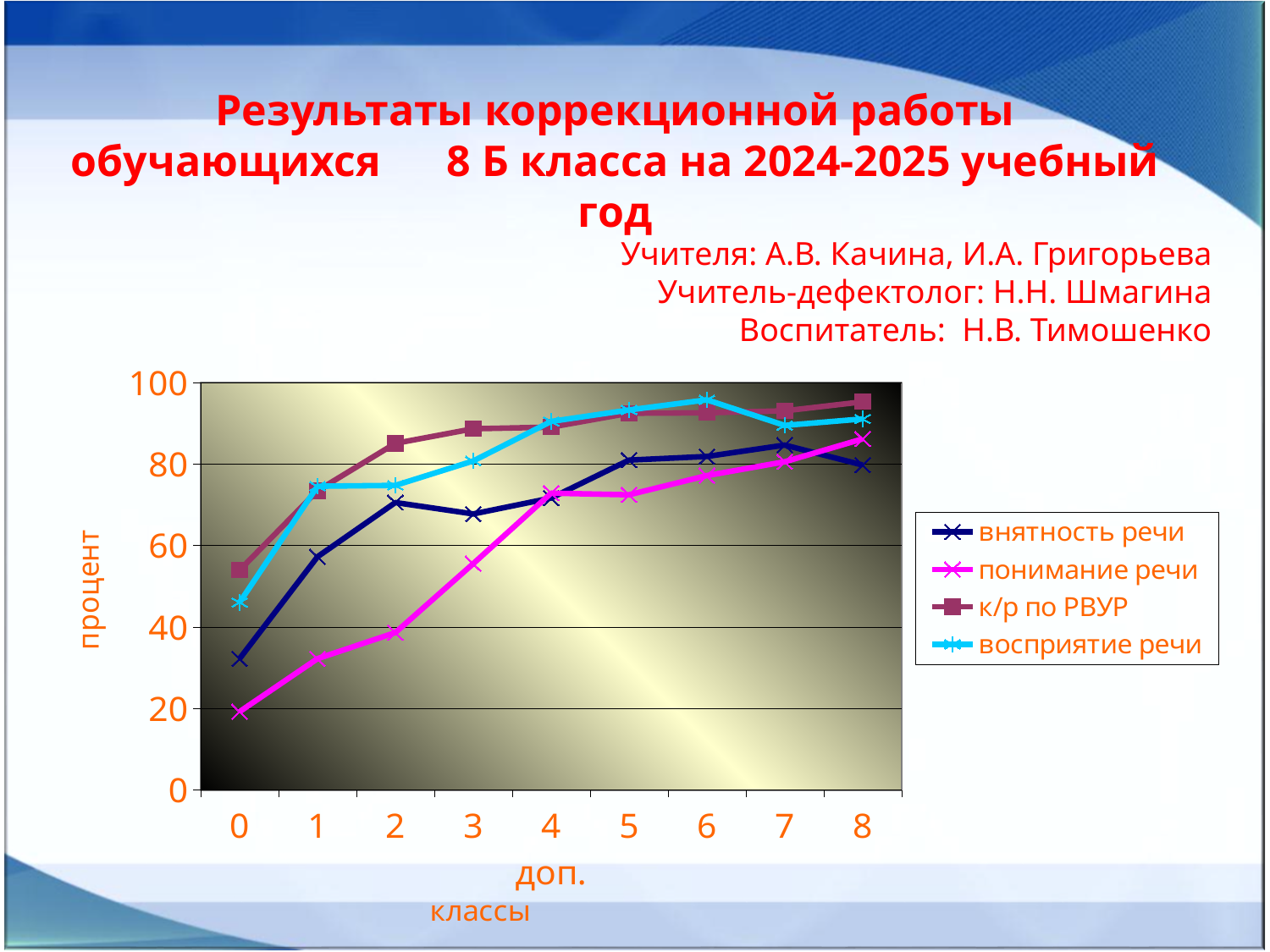
Do the values for понимание речи rise or fall from category 0 to category 8? rise At category 3, which is higher: к/р по РВУР or внятность речи? к/р по РВУР What kind of chart is shown on the slide? line chart How many categories are shown along the x axis? 9 Is the value for к/р по РВУР at category 8 greater or less than 80? greater What is the title of the vertical axis? процент At category 0, which is higher: внятность речи or понимание речи? внятность речи How many series does the legend list? 4 Is the value for внятность речи at category 1 greater or less than 40? greater Is the value for понимание речи at category 0 greater or less than 40? less Which series has the lowest value at category 0? понимание речи Which series has the highest value at category 2? к/р по РВУР